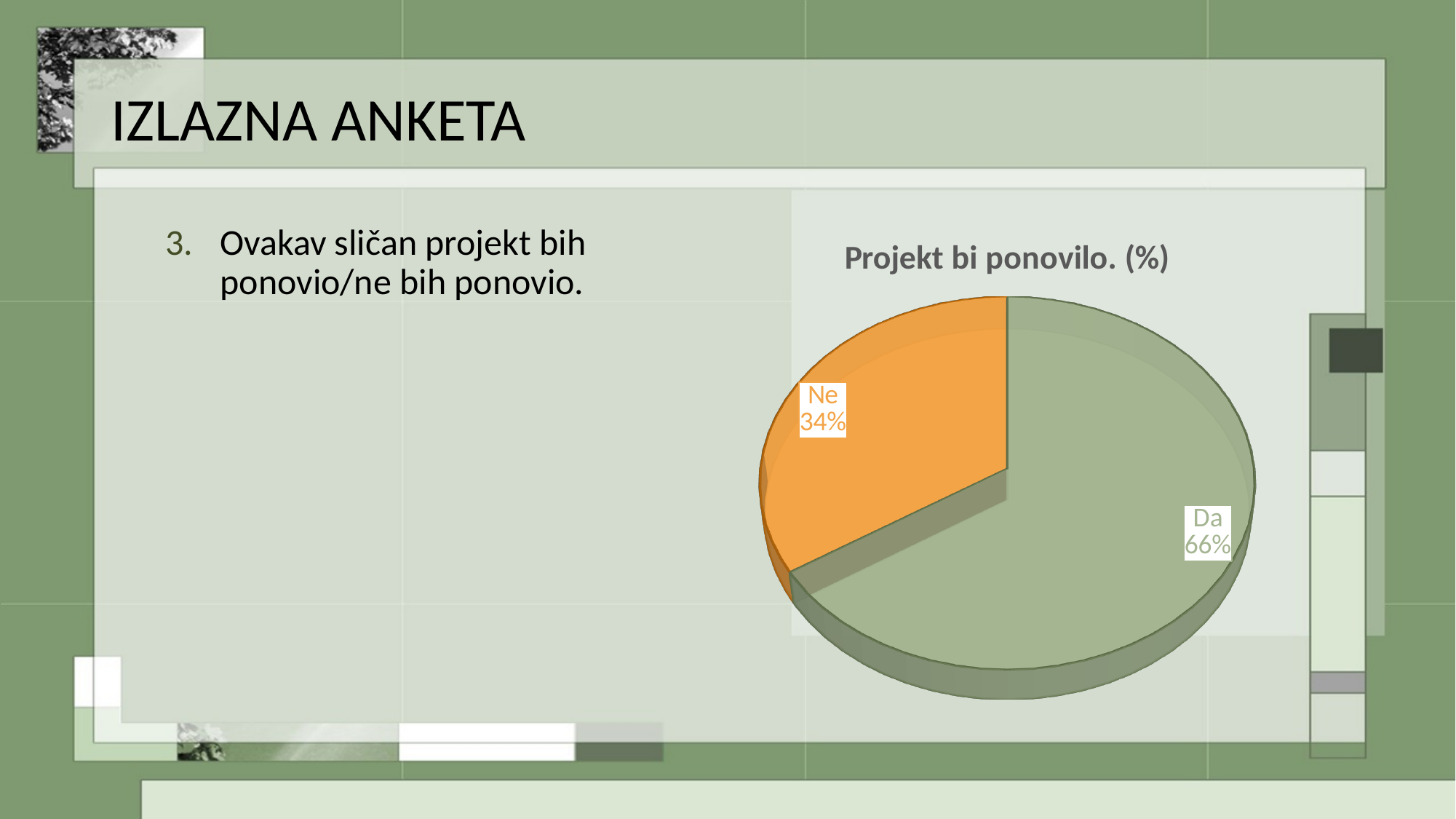
What percentage is shown for the "Da" slice? 66% Which slice is the largest? Da What is the title of the chart? Projekt bi ponovilo. (%) What kind of chart is shown on the slide? pie chart What share of the pie does the "Ne" slice represent? 34% What is the difference in percentage points between the "Da" and "Ne" slices? 32 What colour is the "Ne" slice? orange How many slices does the pie chart have? 2 Which is larger, the "Da" slice or the "Ne" slice? Da Which slice is the smallest? Ne What percentage is shown for the "Ne" slice? 34%